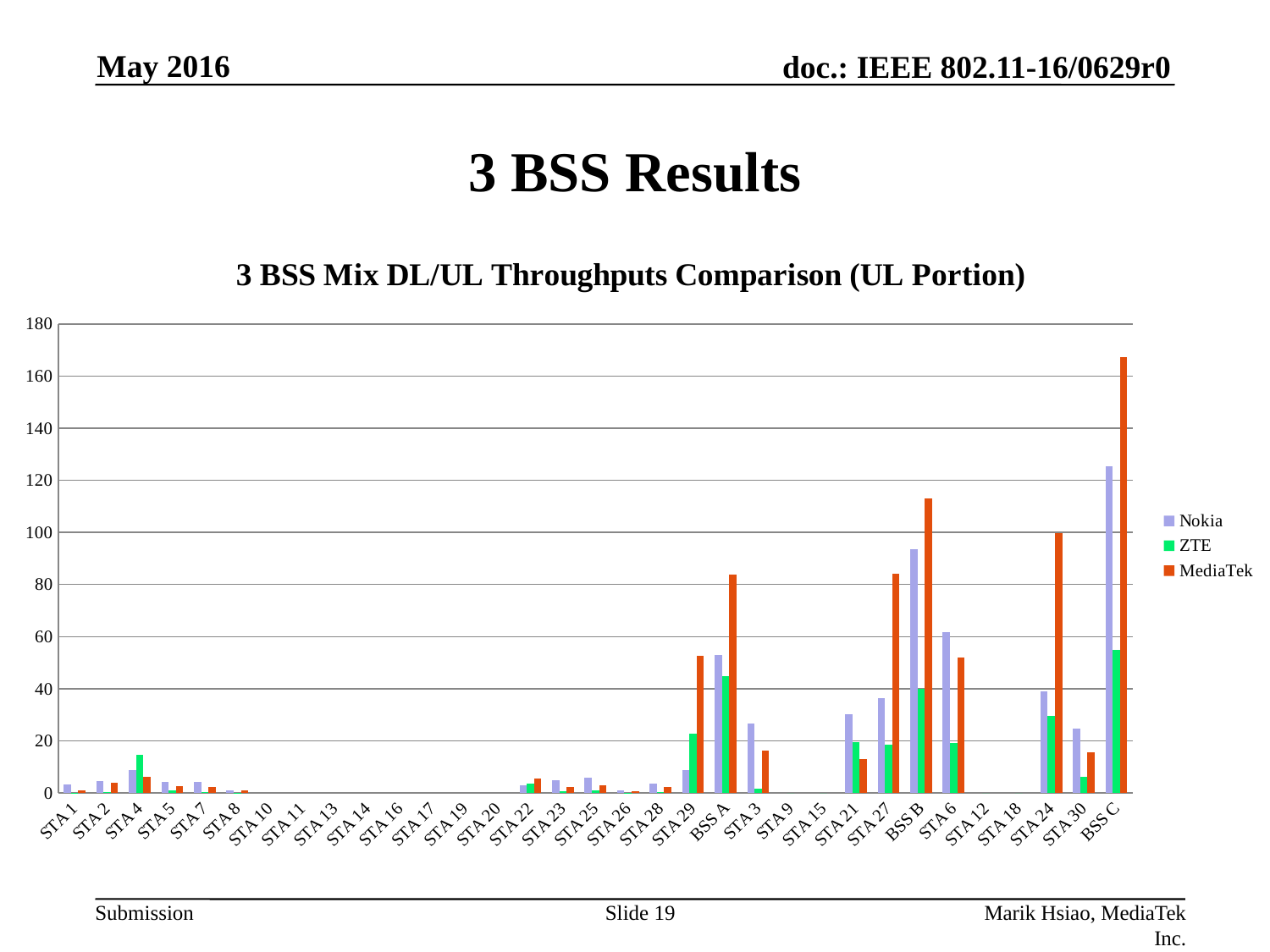
How many series does the legend list? 3 What is the title of the chart? 3 BSS Mix DL/UL Throughputs Comparison (UL Portion) Is the MediaTek value for BSS C greater or less than 160? greater What kind of chart is shown on the slide? bar chart Is the ZTE value for BSS B greater or less than 60? less Which series are listed in the legend? Nokia, ZTE, MediaTek Which category has the highest MediaTek value? BSS C Which category has the highest Nokia value? BSS C For STA 24, which is larger, the Nokia value or the MediaTek value? MediaTek Is the MediaTek value for BSS B greater or less than 100? greater How many categories are shown on the x axis? 33